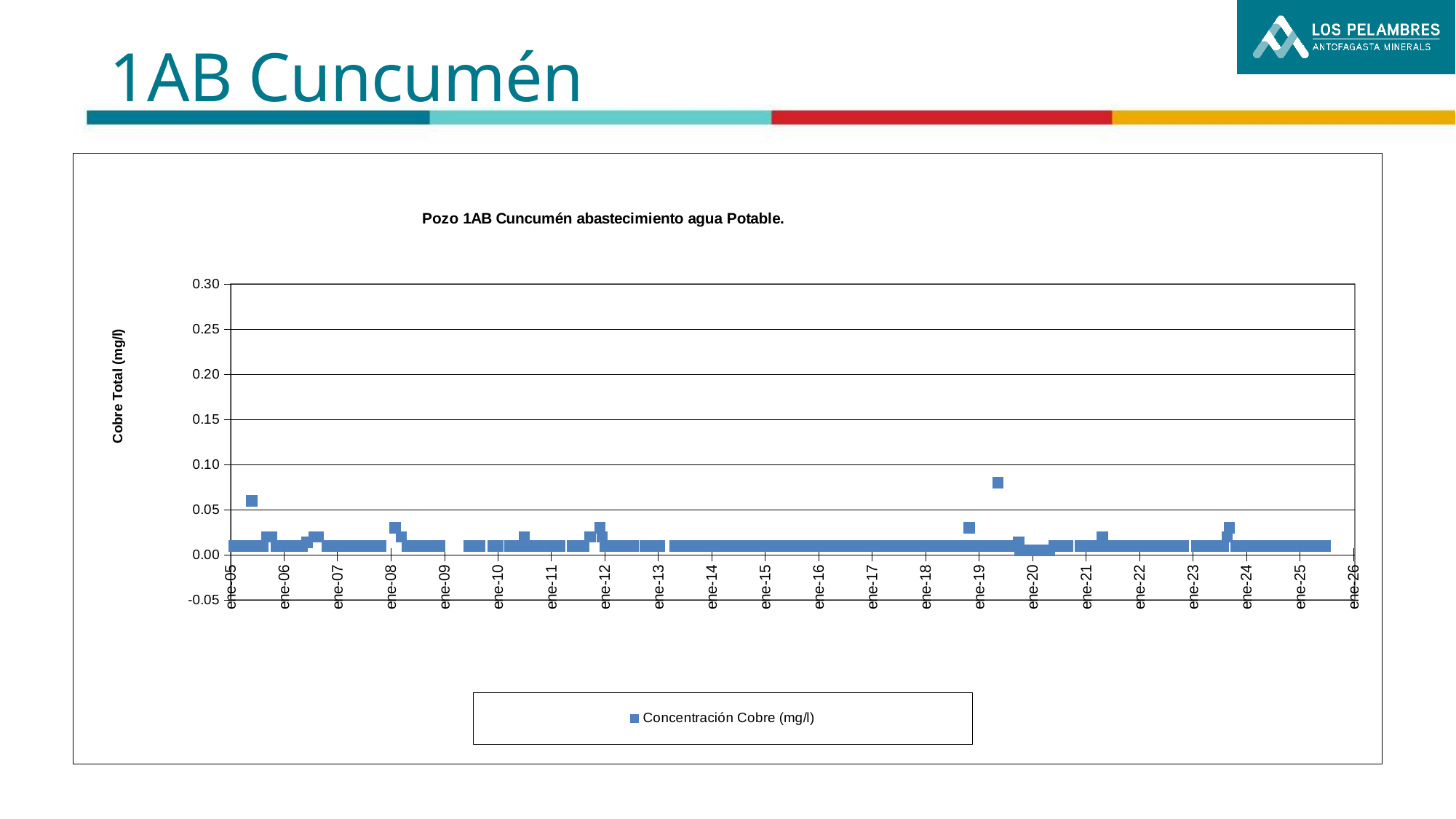
What is the title of the chart? Pozo 1AB Cuncumén abastecimiento agua Potable. Is the value of the isolated high point shortly after ene-05 greater or less than 0.10? less Is the highest plotted value in the chart greater or less than 0.10? less What kind of chart is shown on the slide? scatter chart What is the maximum value shown on the y axis? 0.30 How many year labels are shown on the x axis, from ene-05 to ene-26? 22 Is the highest plotted value in the chart greater or less than 0.05? greater How many series does the chart legend list? 1 Do the plotted values show a clear rising or falling trend along the x axis, or do they stay roughly flat? roughly flat What is the name of the series shown in the legend? Concentración Cobre (mg/l)